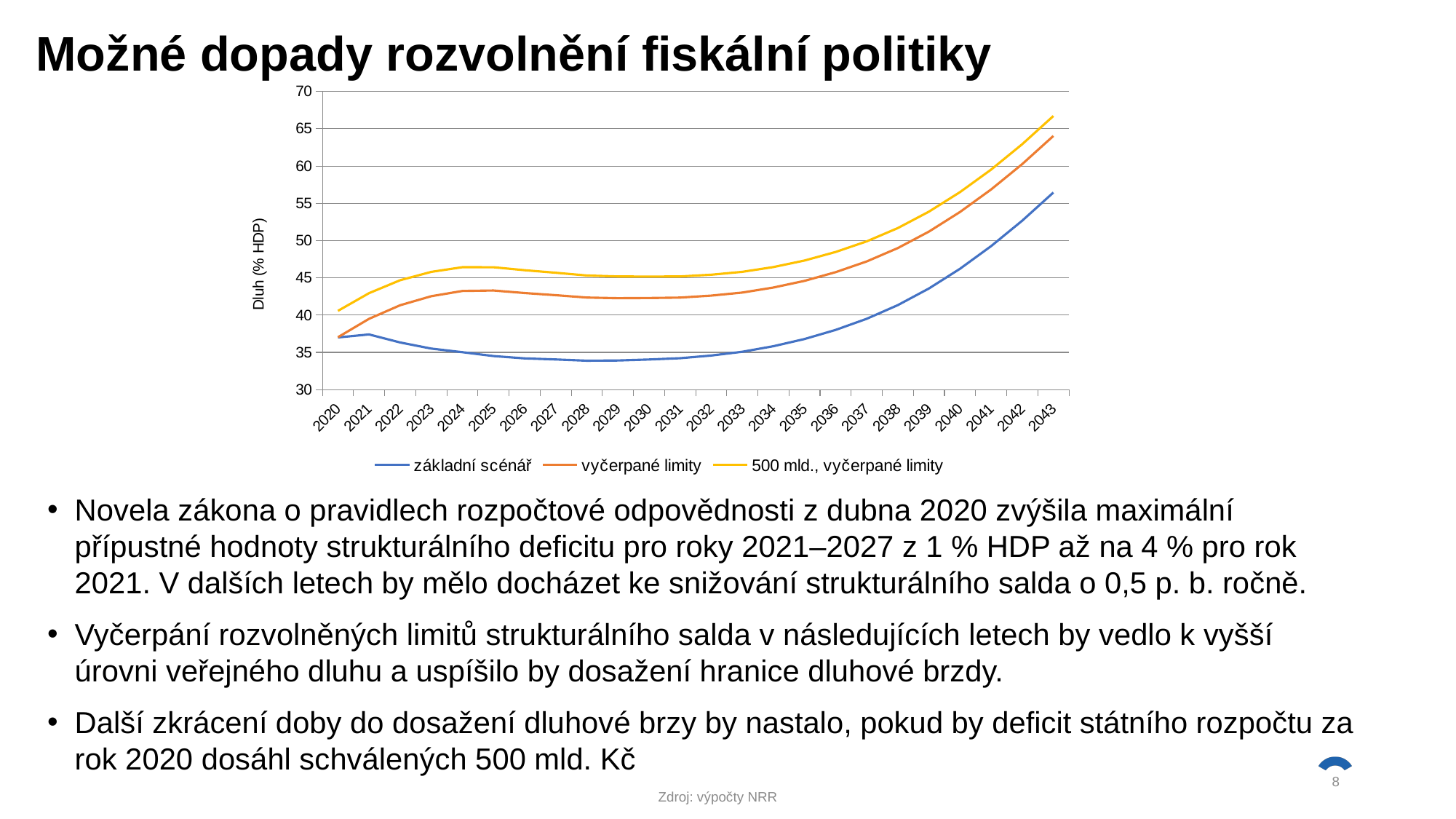
Which series has the highest value in 2043? 500 mld., vyčerpané limity How many years are shown on the x axis of the chart? 24 Does the základní scénář line rise or fall between 2030 and 2043? rise Is the value for 500 mld., vyčerpané limity in 2043 greater or less than 65? greater In 2043, which is larger: základní scénář or vyčerpané limity? vyčerpané limity Is the value for vyčerpané limity in 2043 greater or less than 65? less Is the value for základní scénář in 2028 greater or less than 35? less Which series has the lowest value in 2043? základní scénář What kind of chart is shown on the slide? line chart How many series does the chart legend list? 3 What is the label of the vertical axis of the chart? Dluh (% HDP)